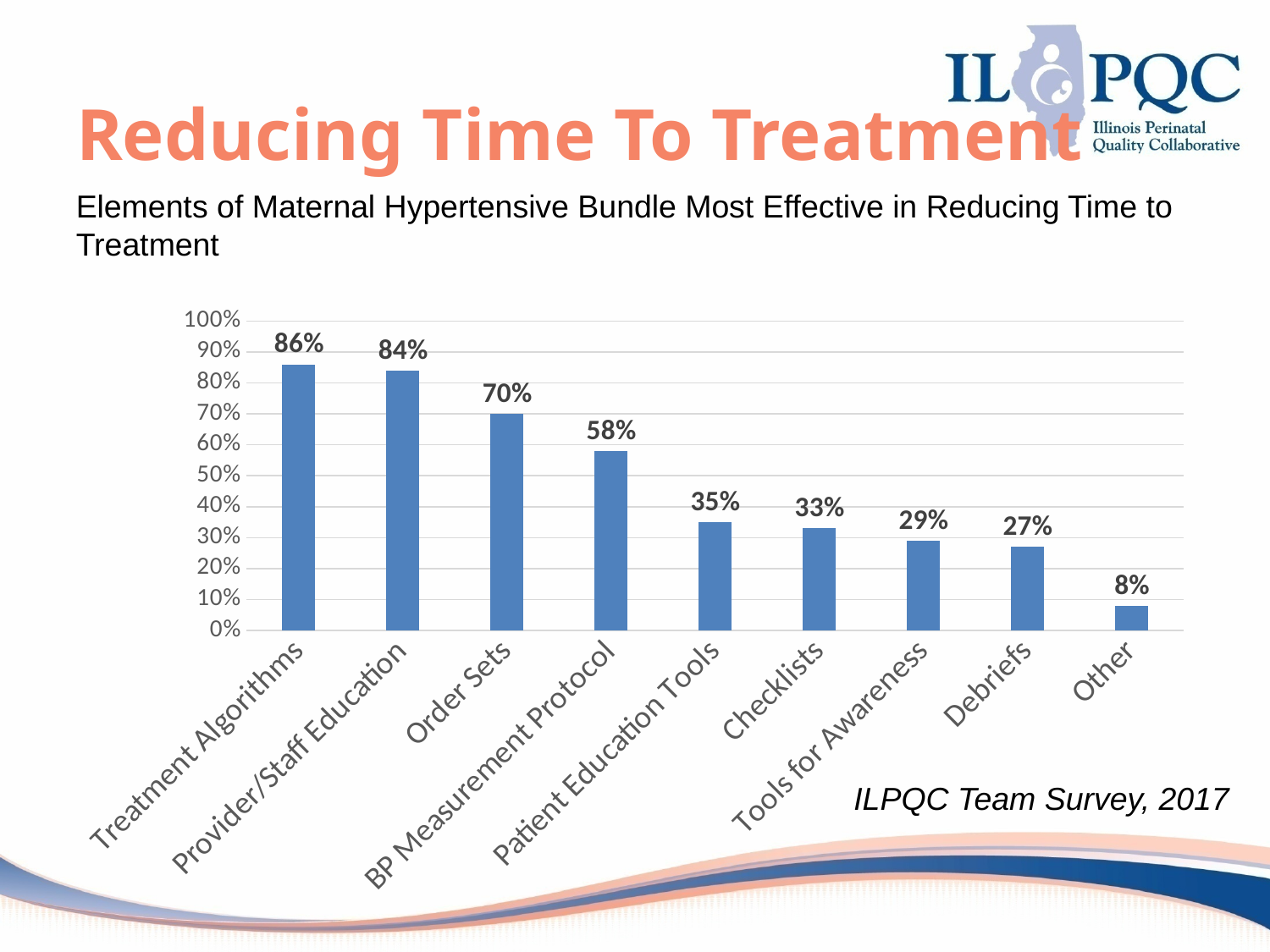
How many categories are shown on the x axis? 9 What kind of chart is shown on the slide? Bar chart What is the value for Checklists? 33% Which category has the highest value? Treatment Algorithms What is the value for Treatment Algorithms? 86% Do the values rise or fall from left to right along the x axis? Fall Which is larger, the value for Patient Education Tools or the value for Tools for Awareness? Patient Education Tools What is the difference between the values for Order Sets and BP Measurement Protocol? 12% Which category has the lowest value? Other Is the value for Provider/Staff Education greater or less than 80%? greater What is the value for Debriefs? 27% What is the value for Order Sets? 70%